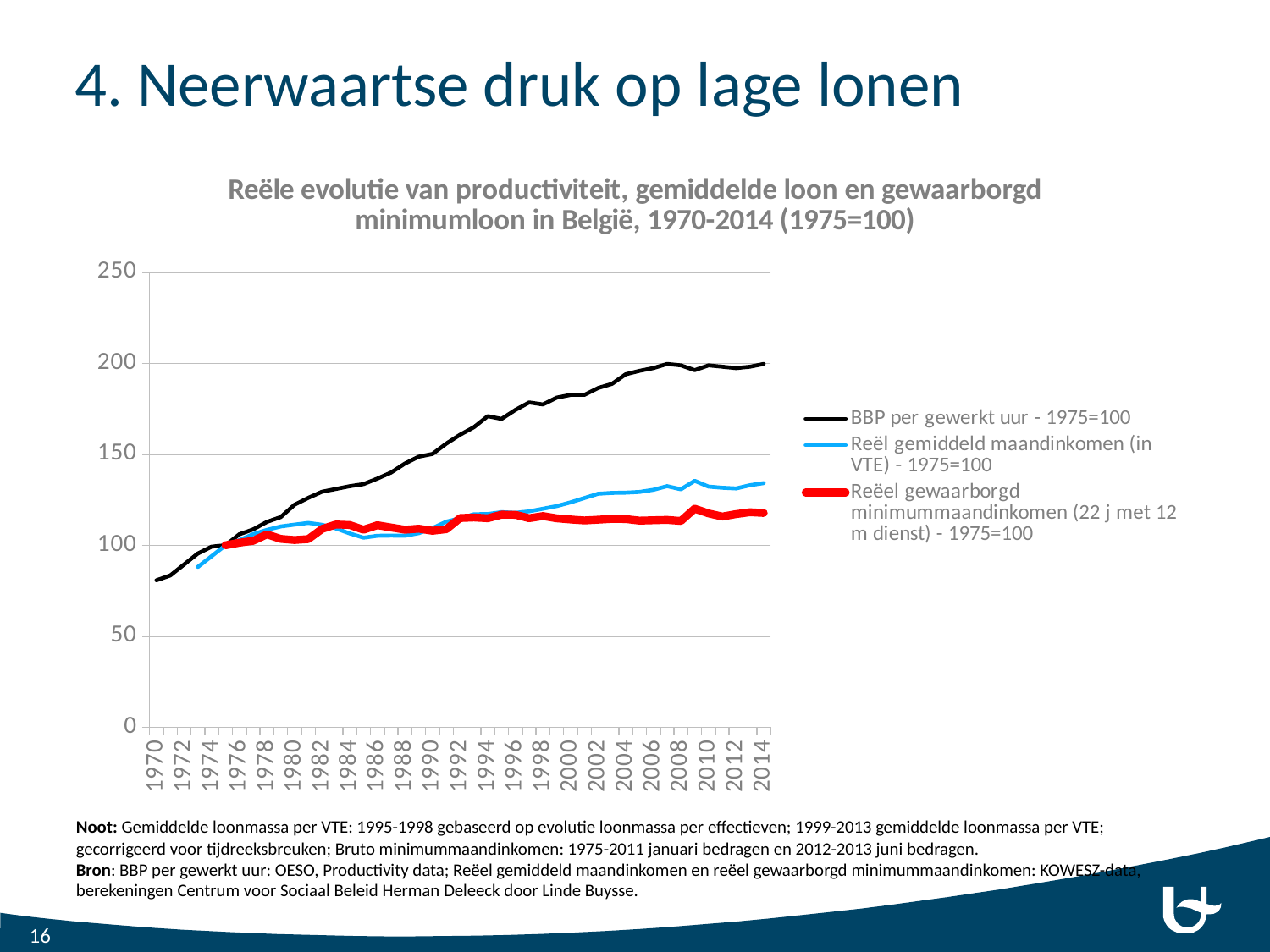
Which series has the lowest value in 2014? Reëel gewaarborgd minimummaandinkomen (22 j met 12 m dienst) - 1975=100 What is the title of the chart? Reële evolutie van productiviteit, gemiddelde loon en gewaarborgd minimumloon in België, 1970-2014 (1975=100) Which series has the highest value in 2014? BBP per gewerkt uur - 1975=100 Which colour is used for the 'Reëel gewaarborgd minimummaandinkomen (22 j met 12 m dienst) - 1975=100' series? red In 2014, which is larger: 'Reël gemiddeld maandinkomen (in VTE) - 1975=100' or 'Reëel gewaarborgd minimummaandinkomen (22 j met 12 m dienst) - 1975=100'? Reël gemiddeld maandinkomen (in VTE) - 1975=100 How many series does the legend list? 3 Does the 'BBP per gewerkt uur - 1975=100' series rise or fall from 1970 to 2014? rise Is the value for 'BBP per gewerkt uur - 1975=100' in 2014 greater or less than 150? greater Is the value for 'Reëel gewaarborgd minimummaandinkomen (22 j met 12 m dienst) - 1975=100' in 2014 greater or less than 150? less What kind of chart is shown on the slide? line chart Is the value for 'Reël gemiddeld maandinkomen (in VTE) - 1975=100' in 2014 greater or less than 150? less